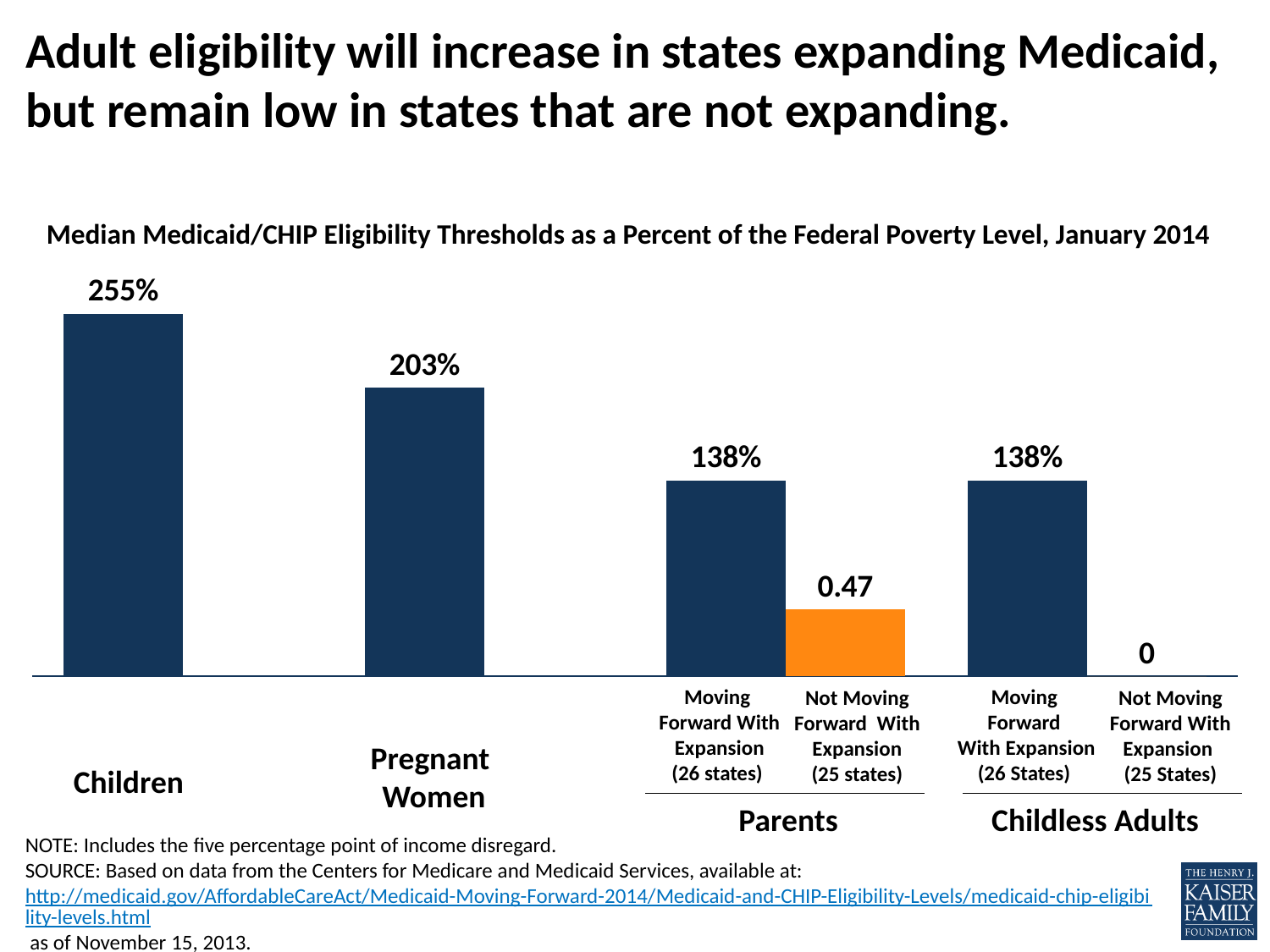
What is the median eligibility threshold shown for Pregnant Women? 203% What is the difference between the eligibility thresholds for Children and Pregnant Women? 52% What value is printed above the bar for Parents in states Not Moving Forward With Expansion (25 states)? 0.47 Which category has the highest median eligibility threshold? Children What type of chart is shown on the slide? Bar chart What is the median Medicaid/CHIP eligibility threshold shown for Children? 255% What is the title of the chart? Median Medicaid/CHIP Eligibility Thresholds as a Percent of the Federal Poverty Level, January 2014 Which category has the lowest value on the chart? Childless Adults, Not Moving Forward With Expansion (25 States) What value is shown for Parents in states Moving Forward With Expansion (26 states)? 138% How many bars are plotted on the chart? 5 Which is larger: the threshold for Pregnant Women or for Parents in states Moving Forward With Expansion? Pregnant Women What value is shown for Childless Adults in states Not Moving Forward With Expansion (25 States)? 0